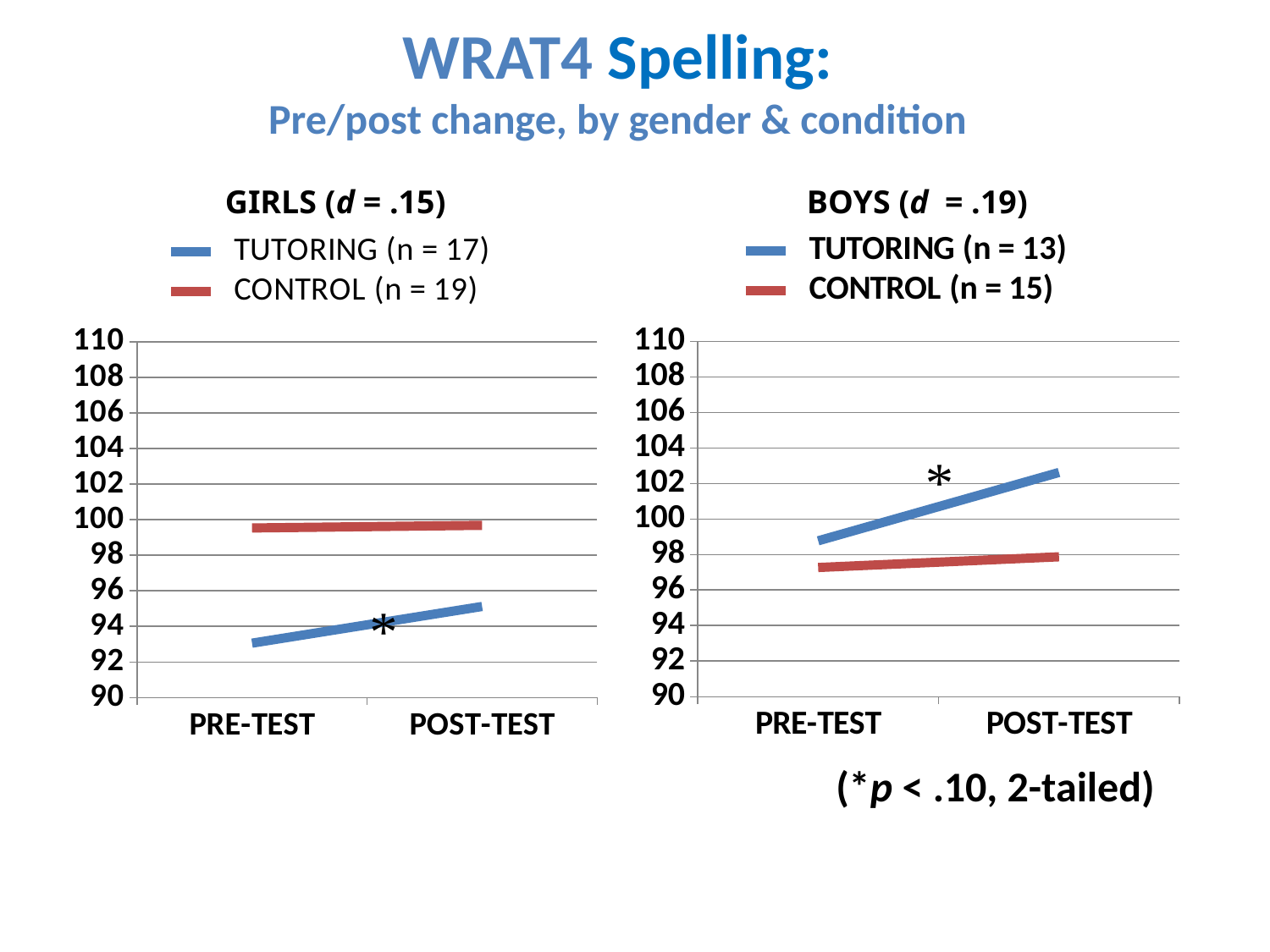
In the BOYS chart, does the TUTORING line rise or fall from PRE-TEST to POST-TEST? rise In the BOYS chart, is the TUTORING value at POST-TEST greater or less than 100? greater In the BOYS chart, is the CONTROL value at PRE-TEST greater or less than 100? less In the BOYS chart, which series is higher at POST-TEST, TUTORING or CONTROL? TUTORING What effect size (d) is shown in the title of the BOYS chart? .19 In the GIRLS chart, what is the sample size (n) shown in the legend for TUTORING? 17 In the GIRLS chart, does the TUTORING line rise or fall from PRE-TEST to POST-TEST? rise How many series does the legend of the BOYS chart list? 2 In the GIRLS chart, is the TUTORING value at PRE-TEST greater or less than 94? less How many points are on the x axis of the GIRLS chart? 2 In the GIRLS chart, which series is higher at PRE-TEST, TUTORING or CONTROL? CONTROL What kind of chart is the GIRLS chart? line chart